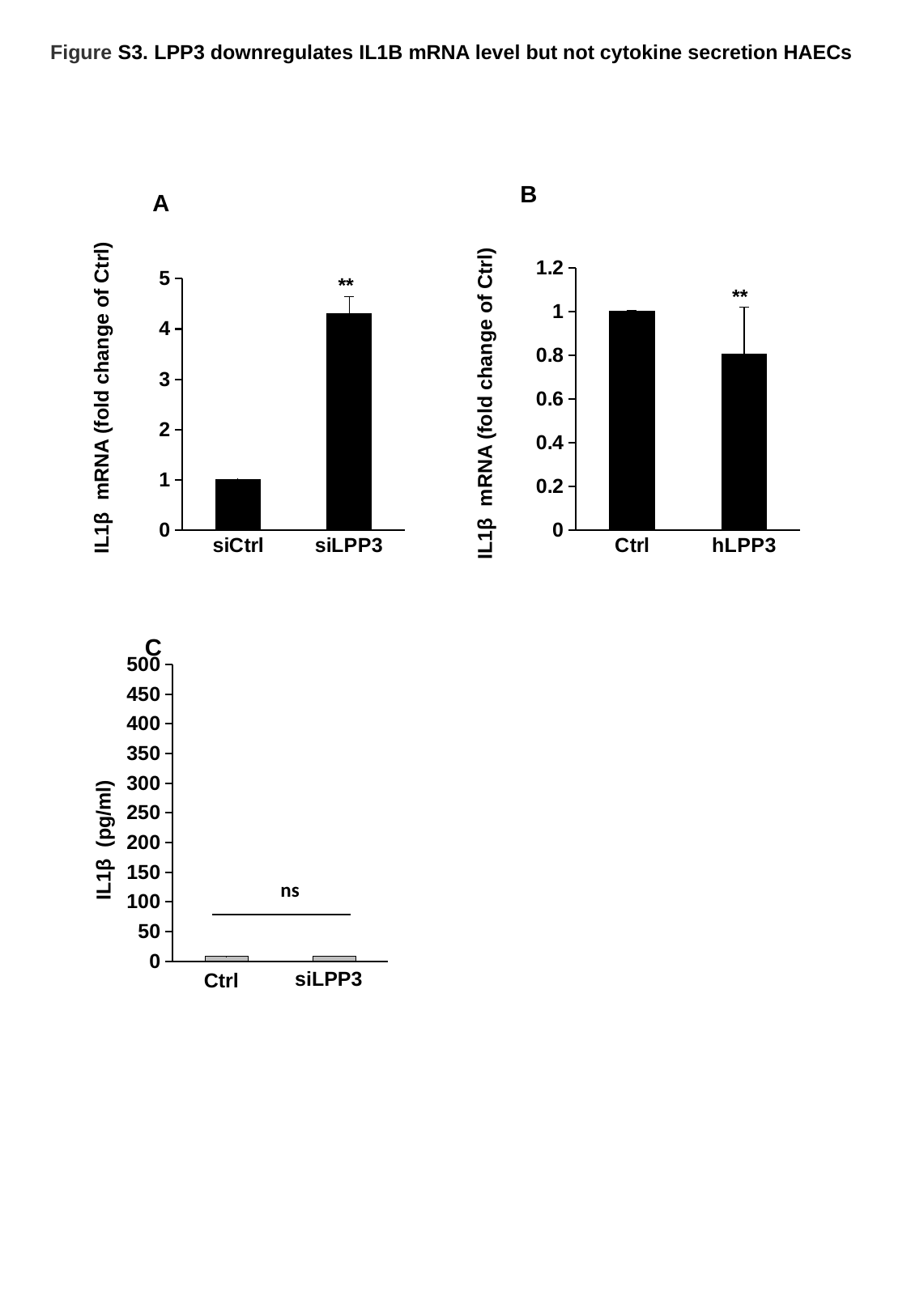
In chart A, what kind of chart is shown? bar chart In chart B, which is larger, the value for Ctrl or the value for hLPP3? Ctrl In chart B, is the value for hLPP3 greater or less than 1? less In chart B, what is the IL1β mRNA fold change for Ctrl? 1 In chart A, which category has the highest bar? siLPP3 In chart B, which category has the lowest bar? hLPP3 In chart C, is the value for siLPP3 greater or less than 50? less In chart A, is the value for siLPP3 greater or less than 4? greater In chart C, what annotation is shown above the bars? ns In chart A, how many categories are shown on the x axis? 2 In chart C, what is the y-axis label? IL1β (pg/ml) In chart A, what is the IL1β mRNA fold change for siCtrl? 1